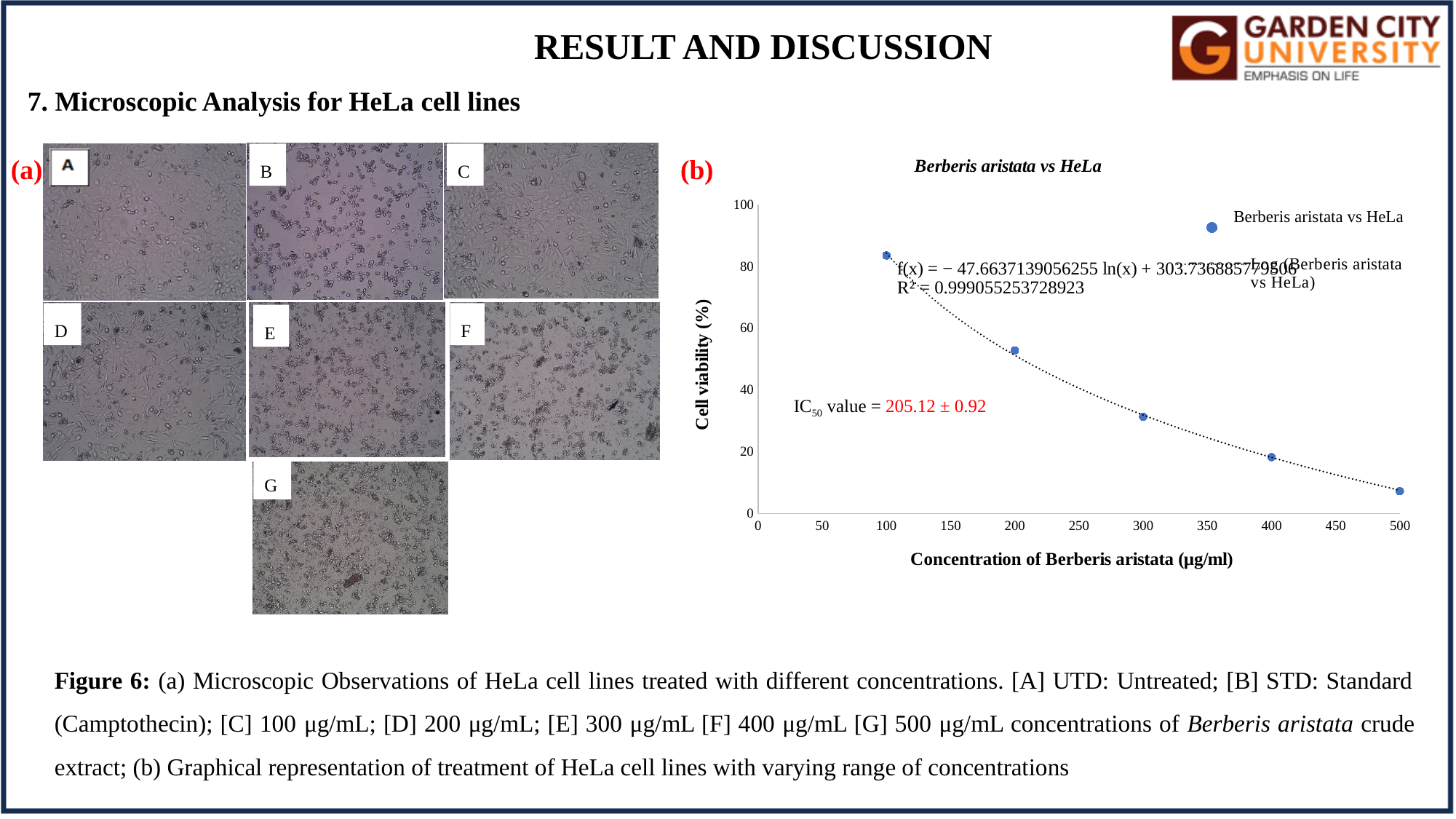
How many data points are plotted in the Berberis aristata vs HeLa chart? 5 In the Berberis aristata vs HeLa chart, does cell viability rise or fall as concentration increases? fall In the Berberis aristata vs HeLa chart, which concentration has the higher cell viability, 200 or 400? 200 In the Berberis aristata vs HeLa chart, is the cell viability at a concentration of 300 greater or less than 40? less What is the title of the chart in panel (b)? Berberis aristata vs HeLa What kind of chart is shown in panel (b)? scatter chart What IC50 value is stated on the Berberis aristata vs HeLa chart? 205.12 ± 0.92 In the Berberis aristata vs HeLa chart, is the cell viability at a concentration of 100 greater or less than 60? greater How many entries does the legend of the Berberis aristata vs HeLa chart list? 2 In the Berberis aristata vs HeLa chart, at which concentration is cell viability lowest? 500 In the Berberis aristata vs HeLa chart, at which concentration is cell viability highest? 100 In the Berberis aristata vs HeLa chart, is the cell viability at a concentration of 500 greater or less than 20? less